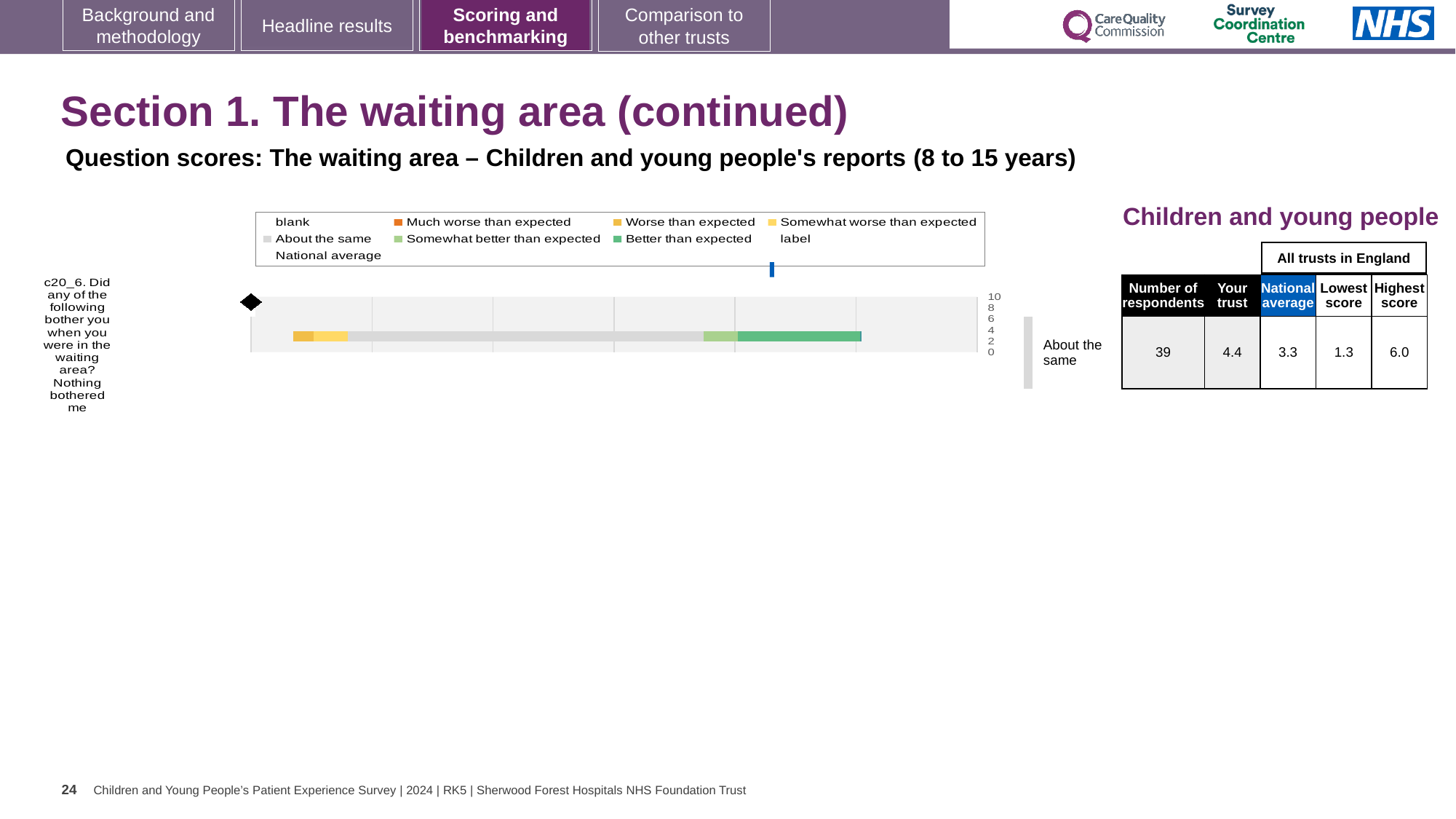
What is the difference between the highest and lowest scores among all trusts in England for question c20_6? 4.7 What is the difference between the 'Your trust' score and the national average for question c20_6? 1.1 What kind of chart is used to show the benchmarking result for question c20_6? bar chart What benchmark category label is shown next to the bar for question c20_6? About the same What is the lowest score among all trusts in England for question c20_6? 1.3 How many survey questions are plotted in the benchmarking chart on this slide? 1 How many respondents answered question c20_6? 39 What is the national average score for question c20_6? 3.3 What is the highest score among all trusts in England for question c20_6? 6.0 Which is larger for question c20_6: the 'Your trust' score or the national average? Your trust What is the 'Your trust' score for question c20_6 in the Children and young people table? 4.4 Which question code is plotted in the benchmarking chart? c20_6